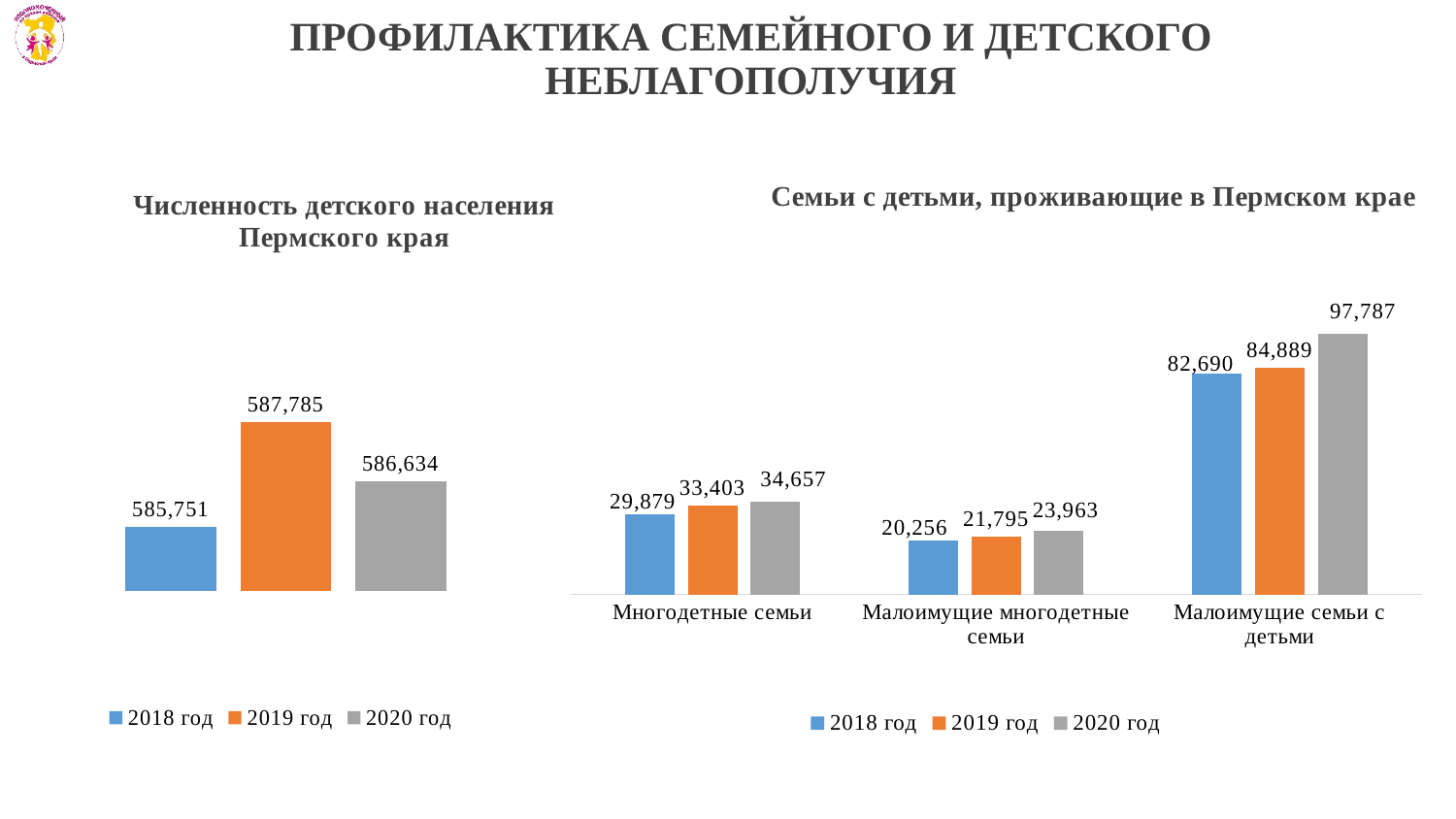
In the chart 'Семьи с детьми, проживающие в Пермском крае', do the values for Малоимущие семьи с детьми rise or fall from 2018 год to 2020 год? rise In the chart 'Численность детского населения Пермского края', how many series does the legend list? 3 In the chart 'Семьи с детьми, проживающие в Пермском крае', which is larger: Многодетные семьи in 2019 год or Малоимущие многодетные семьи in 2019 год? Многодетные семьи in 2019 год In the chart 'Семьи с детьми, проживающие в Пермском крае', how many categories are shown on the x axis? 3 In the chart 'Численность детского населения Пермского края', which year has the lowest value? 2018 год In the chart 'Численность детского населения Пермского края', what is the value for 2019 год? 587,785 What kind of chart is the chart on the right of the slide? bar chart In the chart 'Семьи с детьми, проживающие в Пермском крае', what is the value for Многодетные семьи in 2018 год? 29,879 In the chart 'Семьи с детьми, проживающие в Пермском крае', what is the difference between the 2020 год and 2018 год values for Малоимущие семьи с детьми? 15,097 In the chart 'Семьи с детьми, проживающие в Пермском крае', which category has the highest value in 2020 год? Малоимущие семьи с детьми In the chart 'Численность детского населения Пермского края', what is the difference between the 2019 год and 2018 год values? 2,034 In the chart 'Семьи с детьми, проживающие в Пермском крае', what is the value for Малоимущие многодетные семьи in 2020 год? 23,963